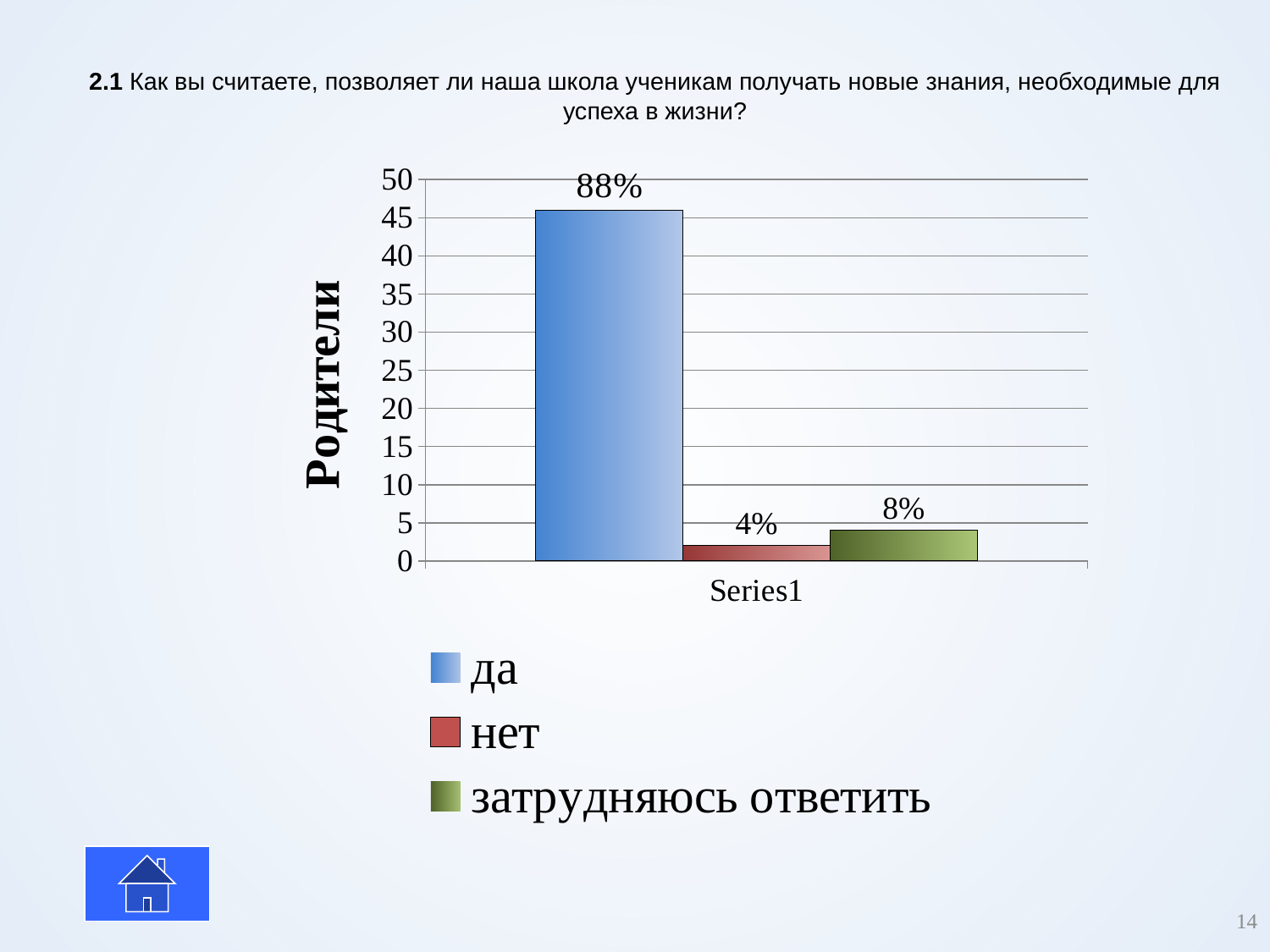
What kind of chart is shown on the slide? Bar chart Which answer option has the highest bar? да What data label is shown on the bar for "затрудняюсь ответить"? 8% What is the title of the vertical axis? Родители By how many percentage points does the "да" label exceed the "нет" label? 84 percentage points Which is larger, the value for "нет" or the value for "затрудняюсь ответить"? затрудняюсь ответить Is the bar for "да" greater or less than 40 on the vertical axis? greater Which answer option has the lowest bar? нет How many series does the legend list? 3 What data label is shown on the bar for "да"? 88% Is the bar for "затрудняюсь ответить" greater or less than 10 on the vertical axis? less What data label is shown on the bar for "нет"? 4%